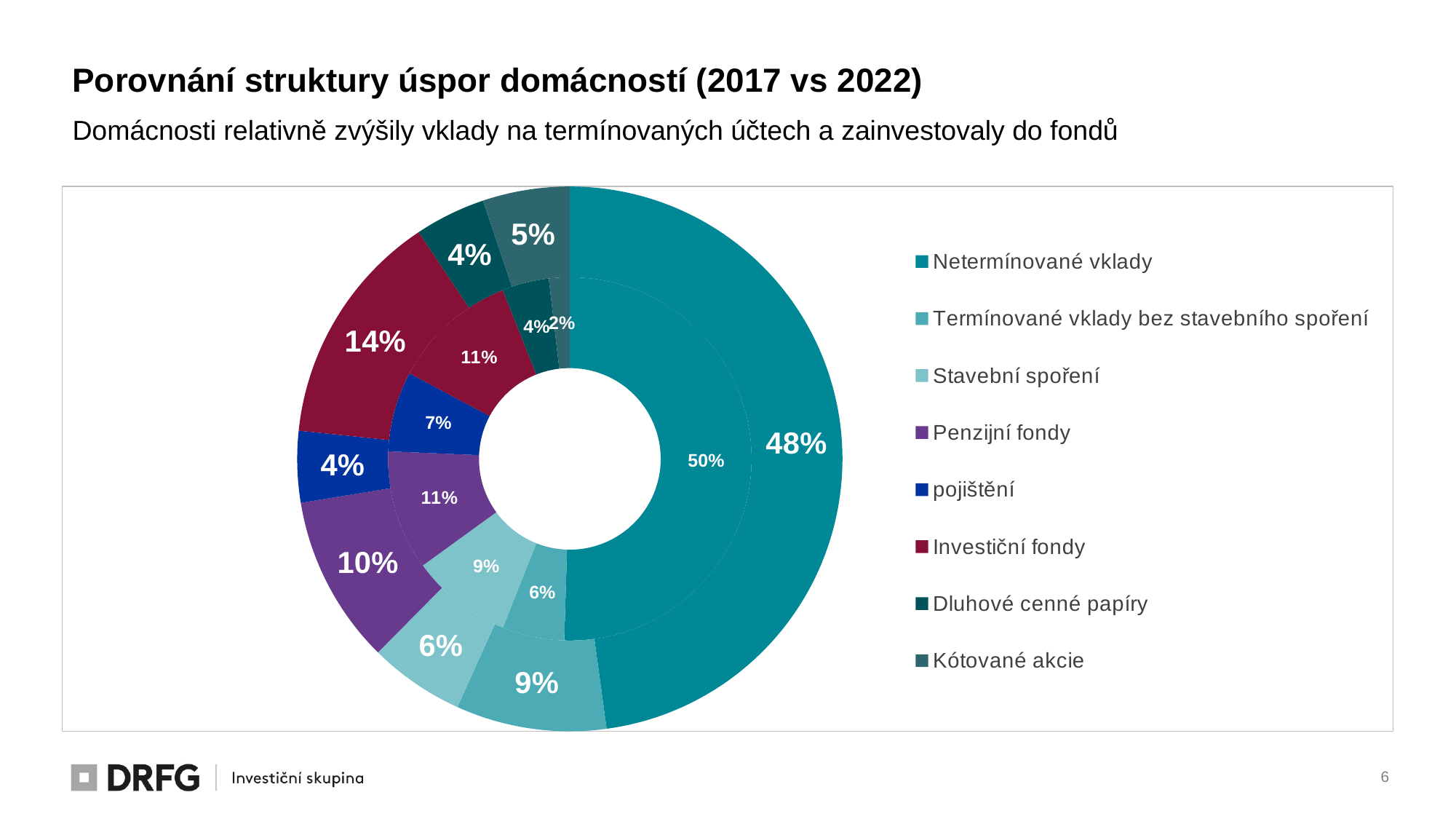
Which category has the largest share in the outer ring? Netermínované vklady What is the value for pojištění in the outer ring? 4% What is the value for Netermínované vklady in the outer ring? 48% How many series does the legend list? 8 What is the value for Investiční fondy in the outer ring? 14% What is the value for Netermínované vklady in the inner ring? 50% What is the value for Penzijní fondy in the inner ring? 11% What kind of chart is shown on the slide? doughnut (pie) chart Which is larger in the outer ring: Termínované vklady bez stavebního spoření or Stavební spoření? Termínované vklady bez stavebního spoření What is the title of the slide? Porovnání struktury úspor domácností (2017 vs 2022) Which category has the smallest share in the inner ring? Kótované akcie What is the difference between the outer-ring and inner-ring values for Investiční fondy? 3%